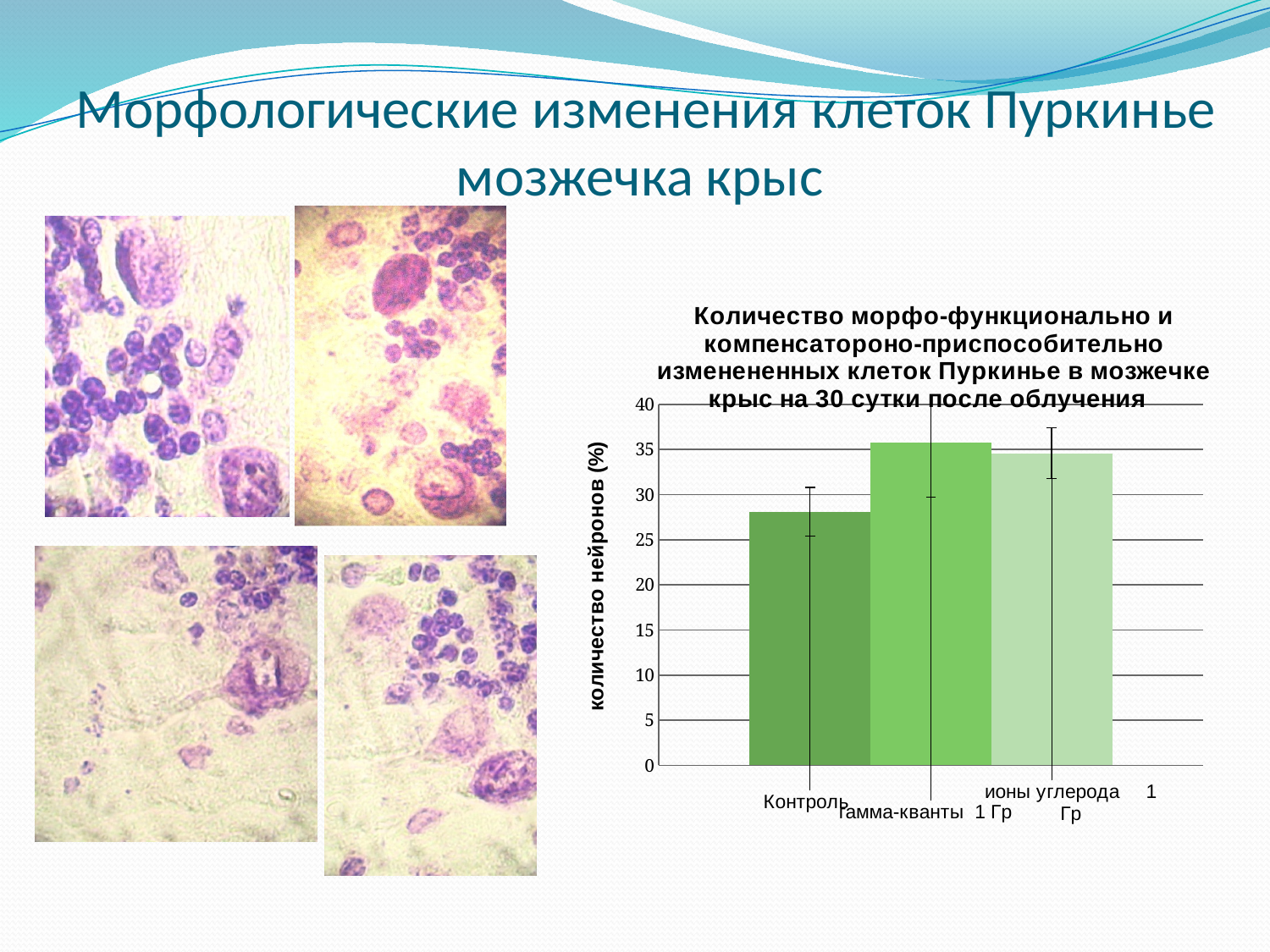
Which is larger, the value for Контроль or the value for Гамма-кванты 1 Гр? Гамма-кванты 1 Гр What kind of chart is shown on the slide? bar chart How many categories (bars) are plotted in the chart? 3 Is the value for ионы углерода 1 Гр greater or less than 30? greater What is the label of the vertical axis of the chart? количество нейронов (%) Is the value for Контроль greater or less than 25? greater Is the value for Гамма-кванты 1 Гр greater or less than 40? less What is the highest tick value shown on the vertical axis of the chart? 40 Which category has the lowest value in the chart? Контроль Which is larger, the value for Контроль or the value for ионы углерода 1 Гр? ионы углерода 1 Гр